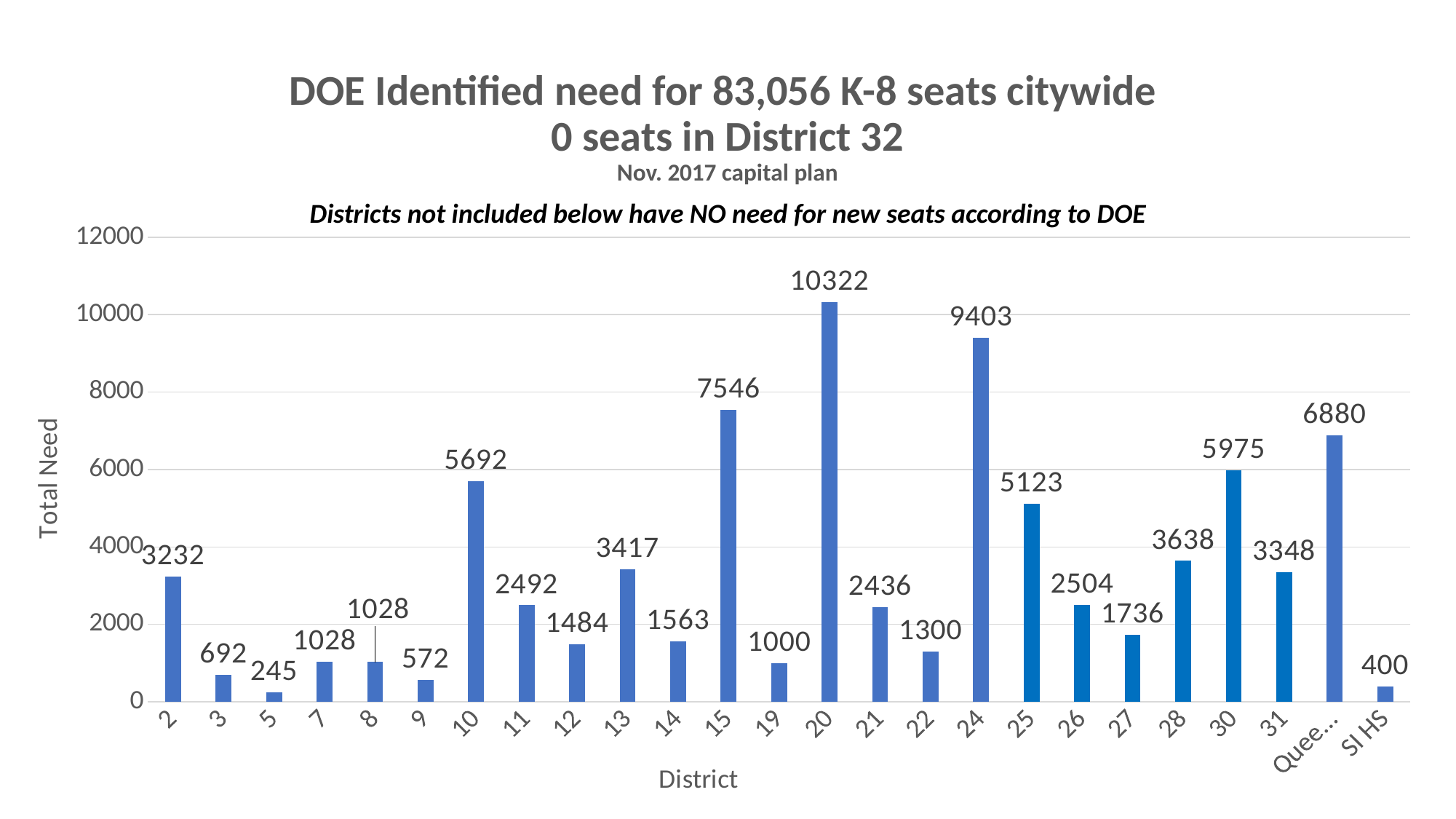
What kind of chart is shown on the slide? Bar chart According to the title, how many K-8 seats did DOE identify a need for citywide? 83,056 How many districts are shown on the x axis? 25 What is the difference in total need between District 20 and District 24? 919 What is the label of the y axis? Total Need Is the value for District 25 greater or less than 4000? greater What is the total need for District 20? 10322 Which has a larger total need, District 10 or District 30? District 30 Which district has the lowest total need? 5 What is the total need for District 15? 7546 Which district has the highest total need? 20 What is the total need for SI HS? 400